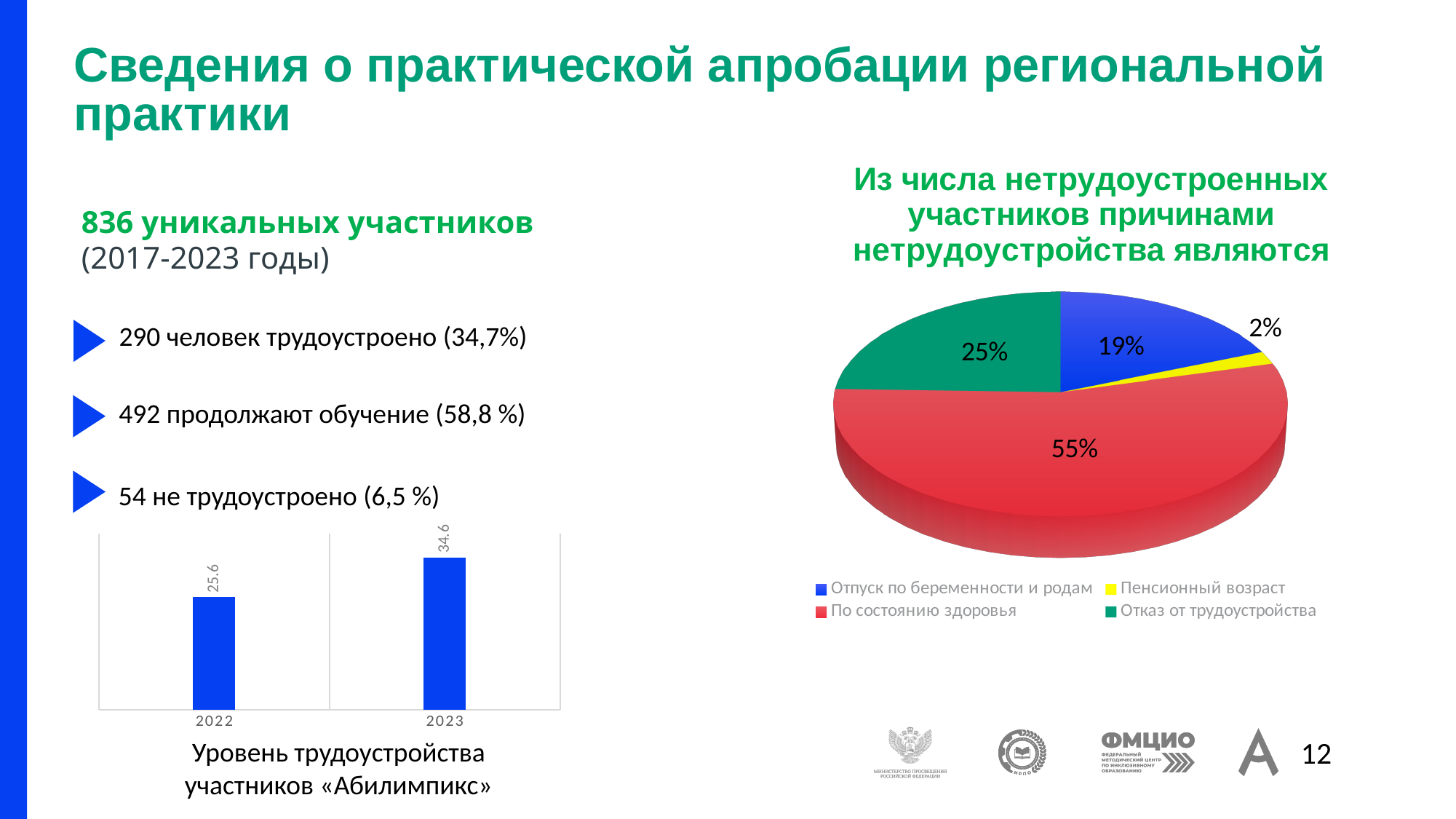
In the pie chart on the right, what share is labelled for «По состоянию здоровья»? 55% In the pie chart on the right, what share is labelled for «Отпуск по беременности и родам»? 19% In the bar chart at the bottom left, what is the value for 2022? 25.6 In the pie chart on the right, which category has the smallest share? Пенсионный возраст In the bar chart at the bottom left, which year has the higher value? 2023 In the bar chart at the bottom left, do the values rise or fall from 2022 to 2023? Rise In the bar chart at the bottom left, what is the difference between the 2023 and 2022 values? 9 In the pie chart on the right, which is larger: «Отказ от трудоустройства» or «Отпуск по беременности и родам»? Отказ от трудоустройства In the bar chart at the bottom left, how many bars are plotted? 2 What type of chart is shown at the bottom left of the slide? Bar chart In the bar chart at the bottom left, what is the value for 2023? 34.6 How many categories does the legend of the pie chart on the right list? 4